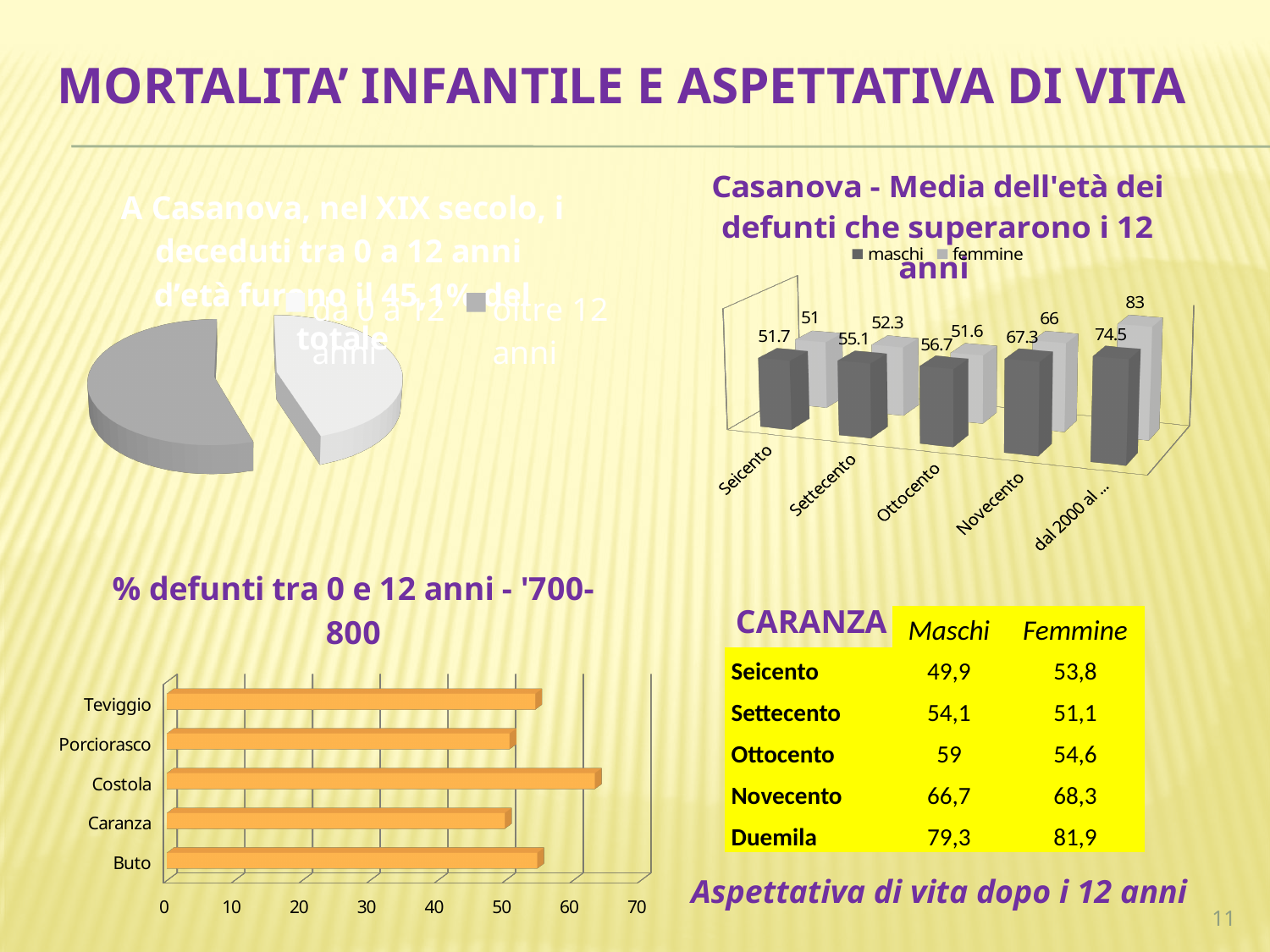
In the chart 'Casanova - Media dell'età dei defunti che superarono i 12 anni', what is the value for maschi in the Seicento? 51.7 What kind of chart is the one at the top left of the slide with the legend 'da 0 a 12 anni' and 'oltre 12 anni'? pie chart In the chart '% defunti tra 0 e 12 anni - '700-800', is the value for Caranza greater or less than 60? less How many localities are shown in the chart '% defunti tra 0 e 12 anni - '700-800'? 5 In the chart '% defunti tra 0 e 12 anni - '700-800', which locality has the highest value? Costola In the chart 'Casanova - Media dell'età dei defunti che superarono i 12 anni', what is the difference between femmine and maschi in the period 'dal 2000 al ...'? 8.5 In the chart 'Casanova - Media dell'età dei defunti che superarono i 12 anni', do the maschi values rise or fall from Seicento to 'dal 2000 al ...'? rise In the chart 'Casanova - Media dell'età dei defunti che superarono i 12 anni', which period has the highest value for maschi? dal 2000 al ... In the chart 'Casanova - Media dell'età dei defunti che superarono i 12 anni', what is the value for femmine in the period 'dal 2000 al ...'? 83 In the chart 'Casanova - Media dell'età dei defunti che superarono i 12 anni', what is the value for femmine in the Novecento? 66 How many series does the legend of the chart 'Casanova - Media dell'età dei defunti che superarono i 12 anni' list? 2 In the chart 'Casanova - Media dell'età dei defunti che superarono i 12 anni', which is larger in the Ottocento, maschi or femmine? maschi